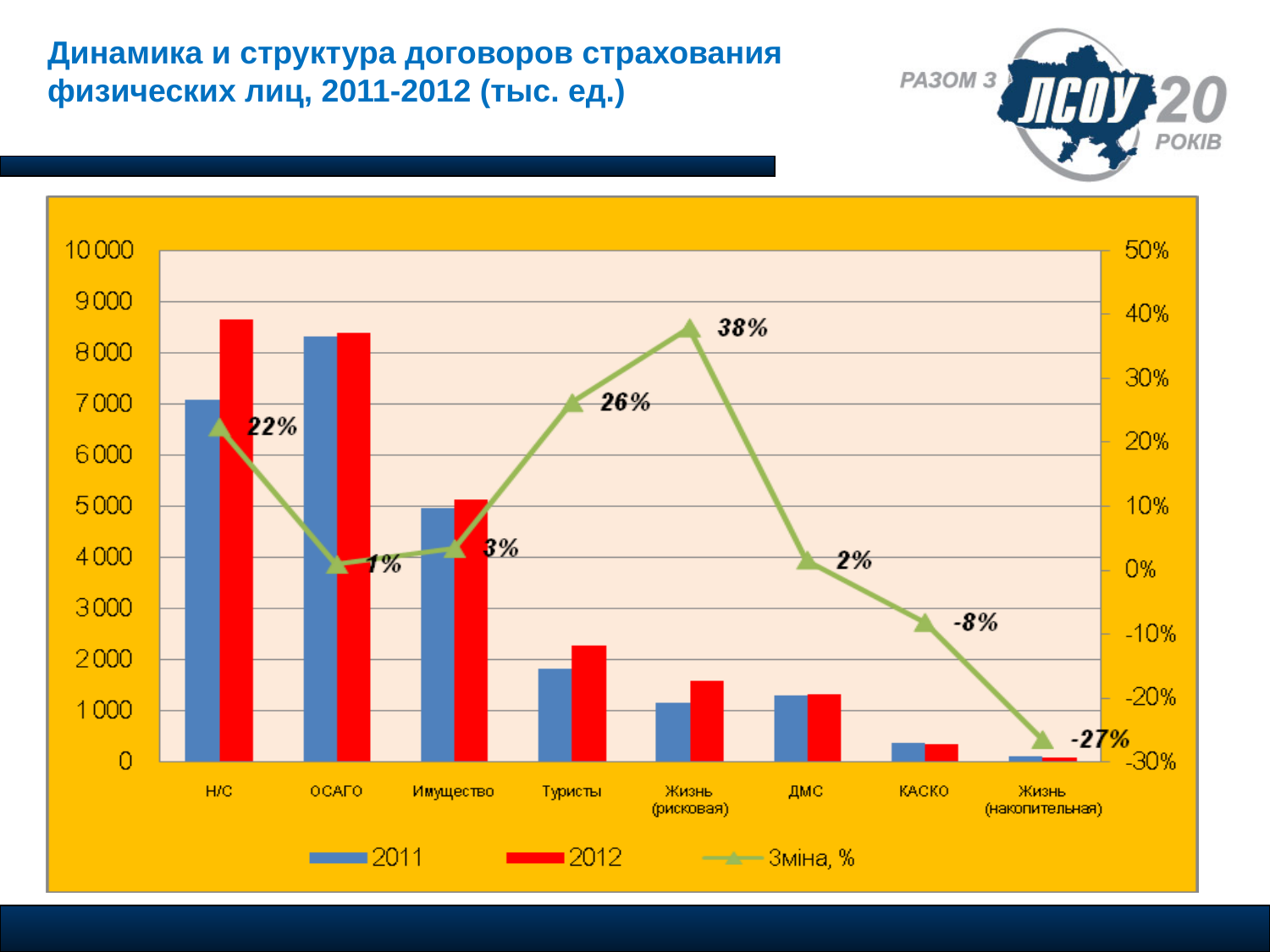
What is the value of the Зміна, % series for Жизнь (накопительная)? -27% Which category has the larger 2011 bar, Н/С or ОСАГО? ОСАГО What is the value of the Зміна, % series for Н/С? 22% Which category has the highest value in the Зміна, % series? Жизнь (рисковая) Is the 2012 value for КАСКО greater or less than 1 000? less What is the value of the Зміна, % series for Жизнь (рисковая)? 38% How many series does the legend list? 3 Is the 2012 value for Туристы greater or less than 2 000? greater How many categories are shown on the x axis? 8 What is the difference between the Зміна, % values for Жизнь (рисковая) and Туристы? 12 percentage points Which category has the lowest value in the Зміна, % series? Жизнь (накопительная) What is the value of the Зміна, % series for КАСКО? -8%